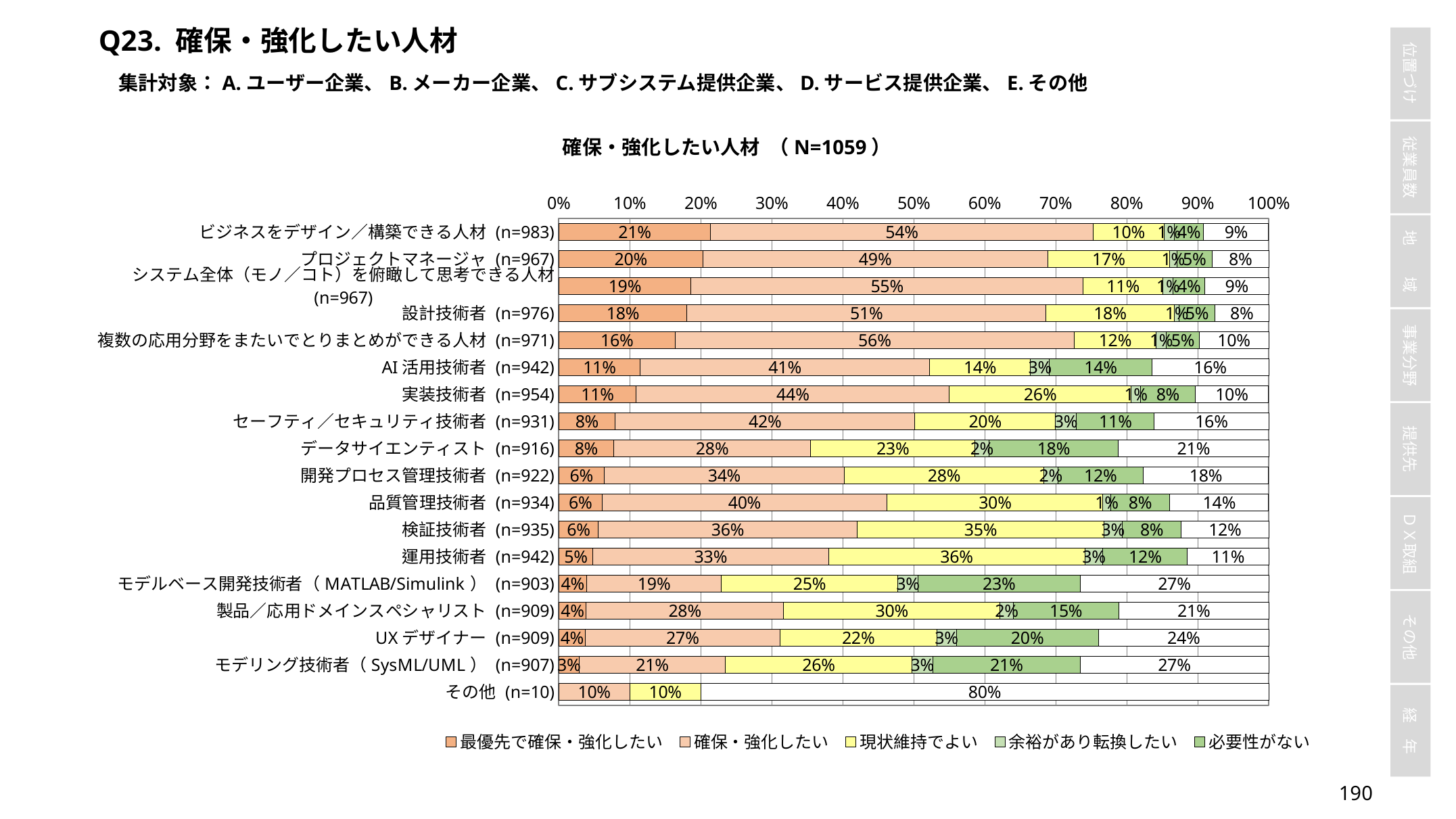
Which category has the lowest 最優先で確保・強化したい share? その他 Which category has the highest 最優先で確保・強化したい share? ビジネスをデザイン／構築できる人材 Which has the larger 確保・強化したい value, 設計技術者 or 実装技術者? 設計技術者 How many categories (bars) are shown in the chart? 18 What is the 現状維持でよい value for 運用技術者? 36% Which category has the highest 必要性がない share? モデルベース開発技術者（MATLAB/Simulink） What is the 必要性がない value for AI 活用技術者? 14% What type of chart is shown on the slide? Stacked bar chart How many series does the legend list? 5 What is the 確保・強化したい value for 複数の応用分野をまたいでとりまとめができる人材? 56% What percentage of respondents chose 最優先で確保・強化したい for ビジネスをデザイン／構築できる人材? 21% What is the difference between the 現状維持でよい values for 実装技術者 and AI 活用技術者? 12 percentage points